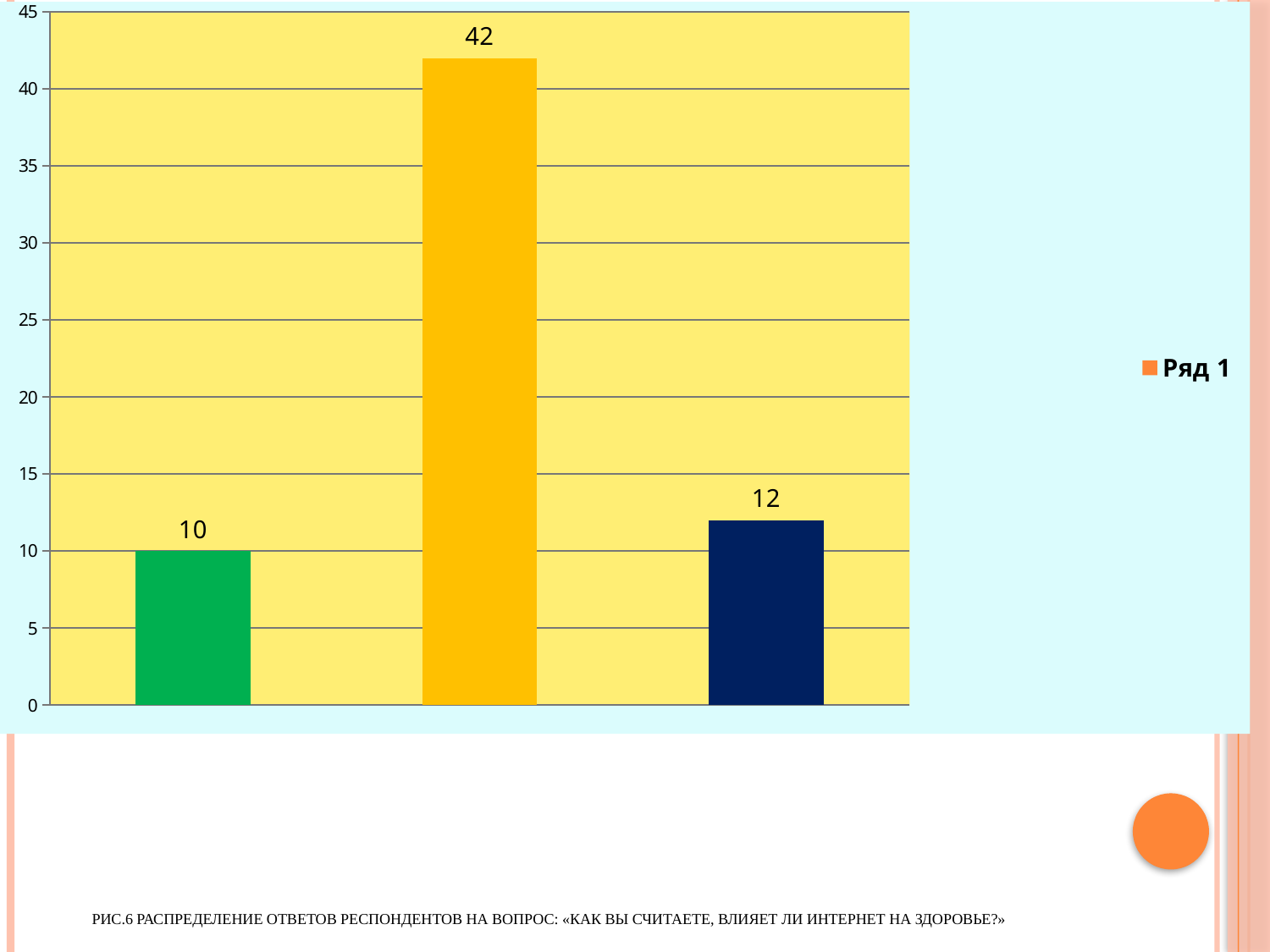
What is the difference between the middle bar and the right bar? 30 What is the value of the dark blue bar on the right? 12 What is the total of the three bars? 64 Which is larger, the left bar or the right bar? the right bar How many series does the legend list? 1 Which bar has the highest value? the middle (yellow) bar What is the value of the green bar on the left? 10 Which bar has the lowest value? the left (green) bar What is the value of the yellow bar in the middle? 42 How many bars are plotted in the chart? 3 What is the name of the series shown in the legend? Ряд 1 What type of chart is shown on the slide? bar chart